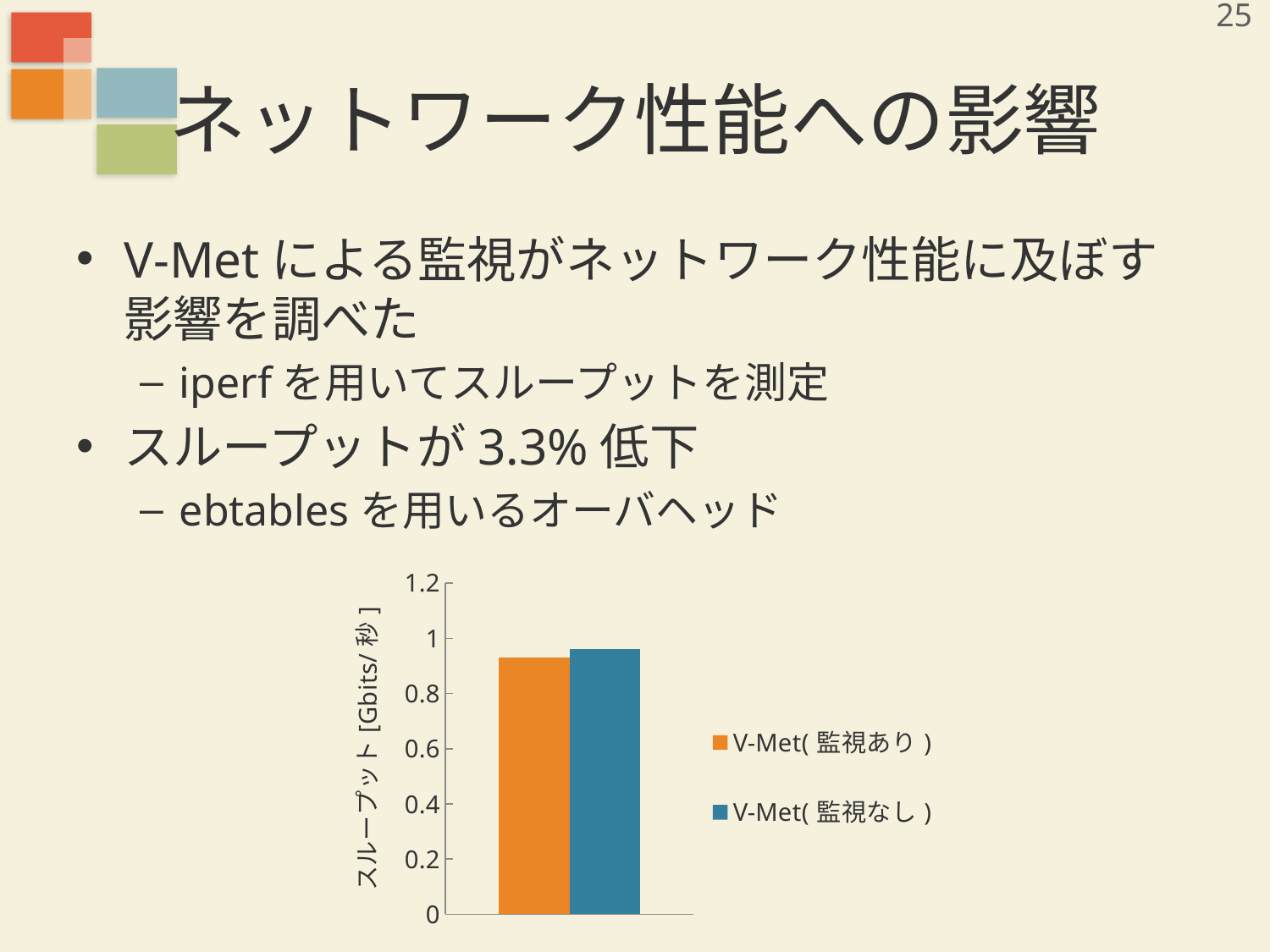
Is the value for V-Met(監視あり) greater or less than 1? less What colour is the bar for V-Met(監視あり) in the chart? orange Which series has the taller bar, V-Met(監視あり) or V-Met(監視なし)? V-Met(監視なし) How many bars are plotted in the chart? 2 Is the value for V-Met(監視なし) greater or less than 1? less What kind of chart is shown on the slide? bar chart Is the value for V-Met(監視あり) greater or less than 0.8? greater Which series has the lowest bar in the chart? V-Met(監視あり) What is the label of the chart's vertical axis? スループット [Gbits/秒] How many series does the chart's legend list? 2 Which series has the highest bar in the chart? V-Met(監視なし)